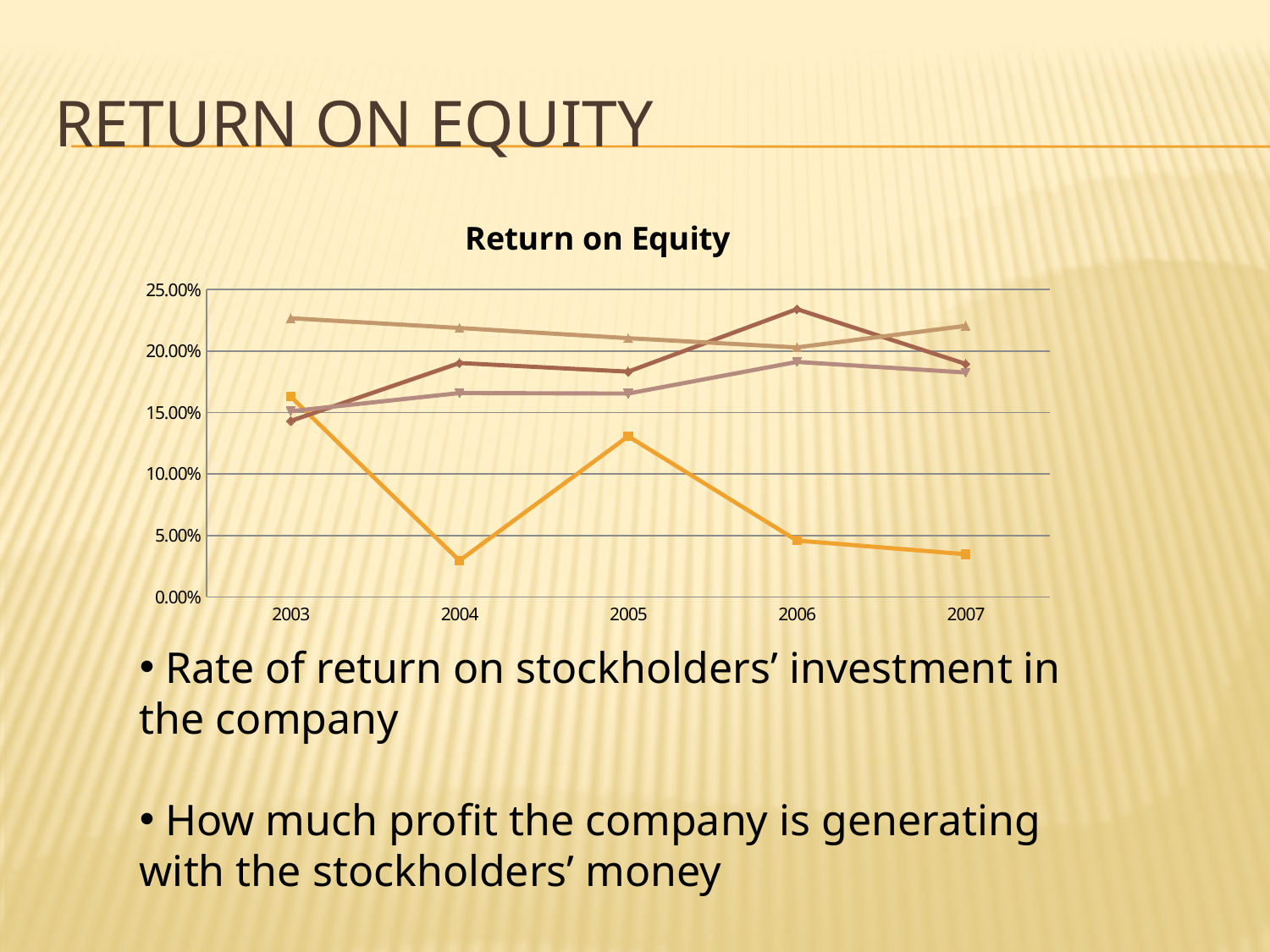
Is the value of the orange line with square markers in 2004 greater or less than 5.00%? less What is the last year shown on the x axis? 2007 Is the value of the light tan line with triangle markers in 2003 greater or less than 20.00%? greater In which year does the orange line with square markers reach its lowest point? 2007 What is the first year shown on the x axis? 2003 What kind of chart is shown on the slide? line chart How many lines are plotted on the chart? 4 What is the title of the chart? Return on Equity How many years are shown on the x axis of the chart? 5 What is the highest value shown on the y axis of the chart? 25.00% Is the value of the orange line with square markers in 2005 greater or less than 10.00%? greater